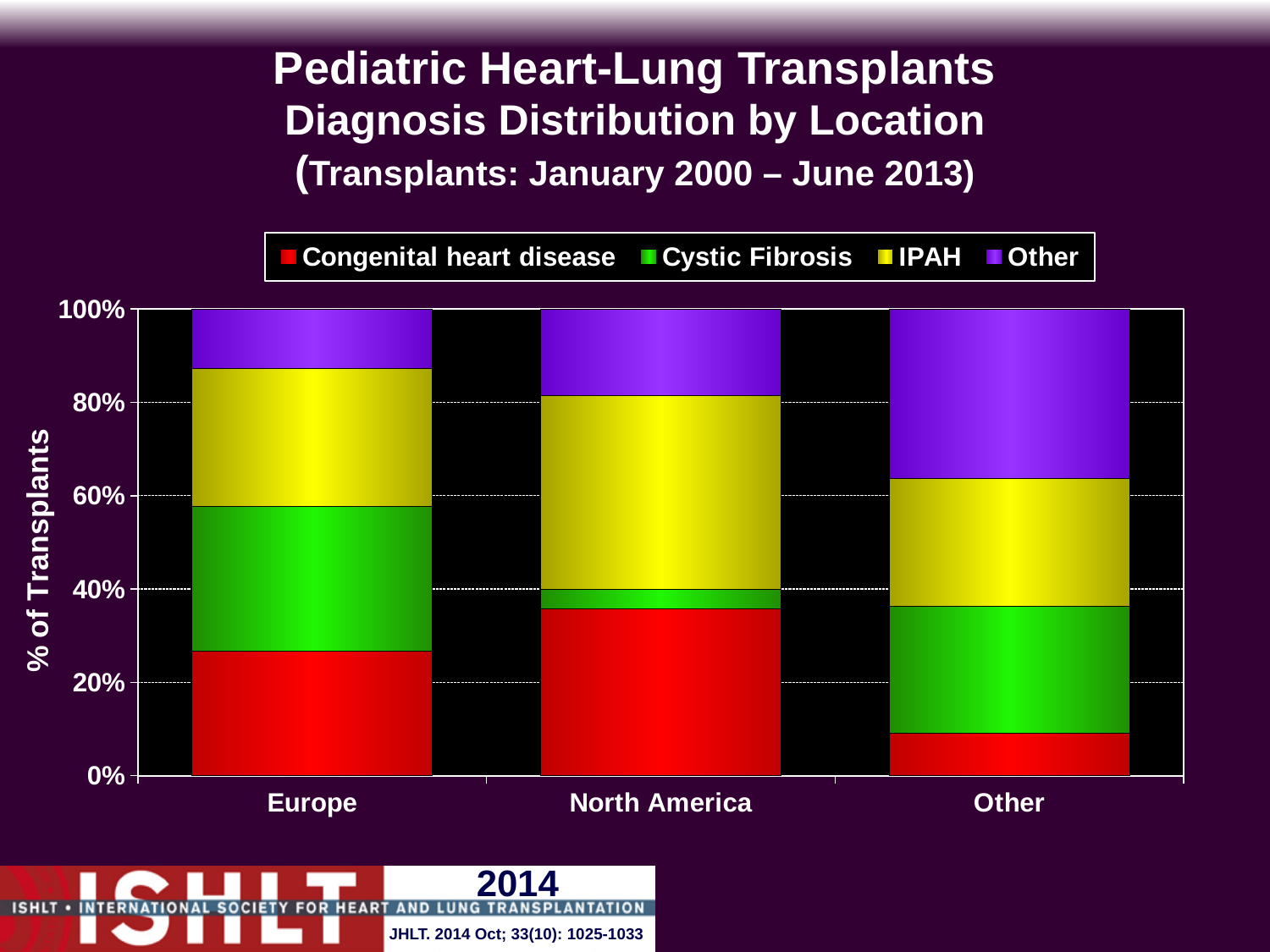
Which location has the largest 'Other' diagnosis segment? Other What is the total height of each stacked bar? 100% Is the Congenital heart disease share for Other greater or less than 20%? less Is the Congenital heart disease share for North America greater or less than 40%? less How many series does the legend list? 4 Which location has the smallest Cystic Fibrosis segment? North America How many location categories are shown on the x axis? 3 What kind of chart is shown on the slide? Stacked bar chart Is the Congenital heart disease share for Europe greater or less than 20%? greater Which location has the largest Congenital heart disease segment? North America Which has a larger Cystic Fibrosis share, Europe or North America? Europe Which location has the smallest Congenital heart disease segment? Other